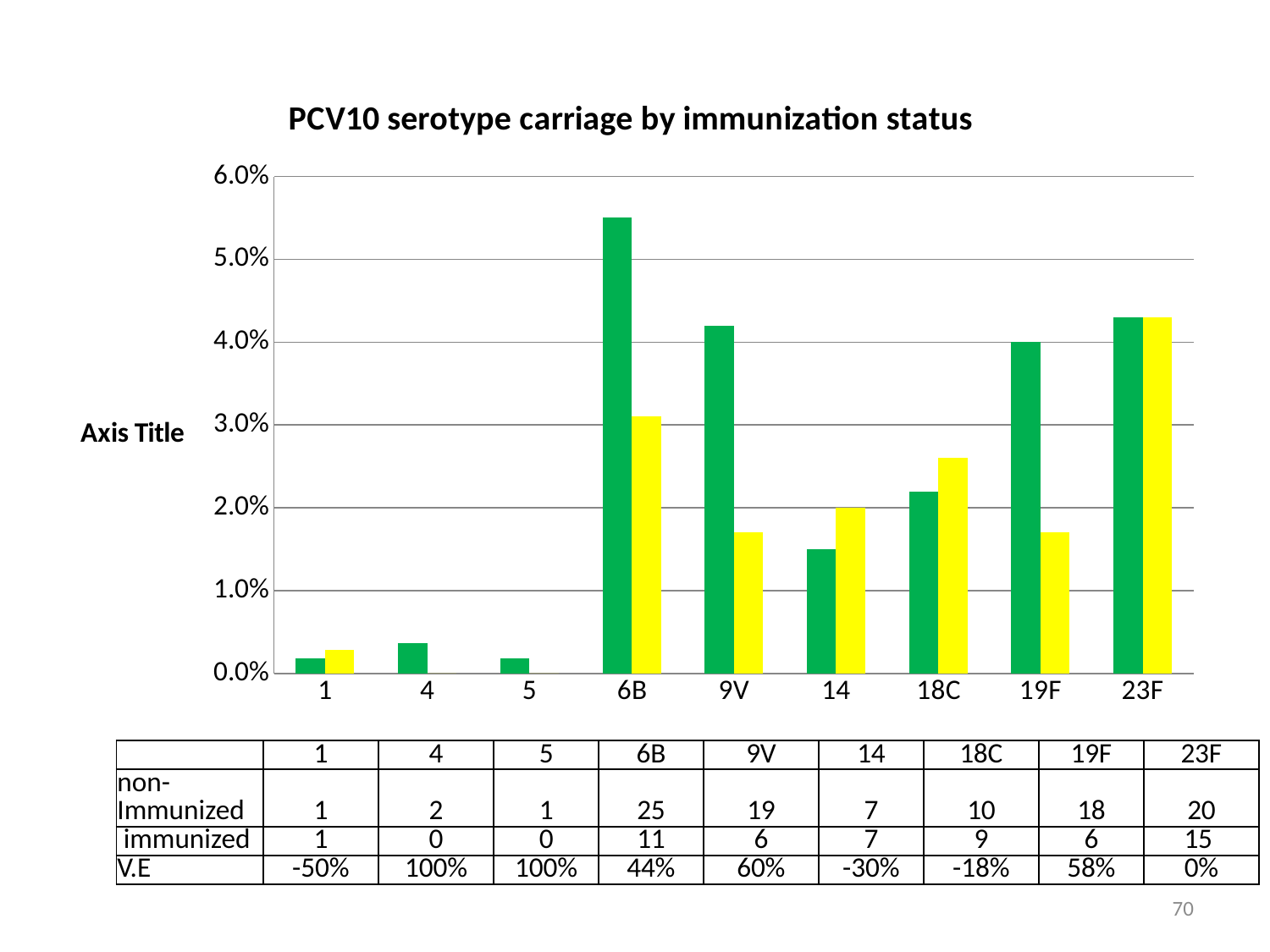
Is the green bar for 6B greater or less than 5.0%? greater What kind of chart is shown on the slide? bar chart Which serotype has the tallest yellow bar? 23F Is the green bar for 14 greater or less than 2.0%? less Which serotype has the tallest green bar? 6B Is the yellow bar for 9V greater or less than 2.0%? less How many serotype categories are shown on the x axis of the chart? 9 What label is shown on the vertical axis of the chart? Axis Title For serotype 14, which bar is taller, the green or the yellow? yellow For serotype 6B, which bar is taller, the green or the yellow? green What is the title of the chart? PCV10 serotype carriage by immunization status